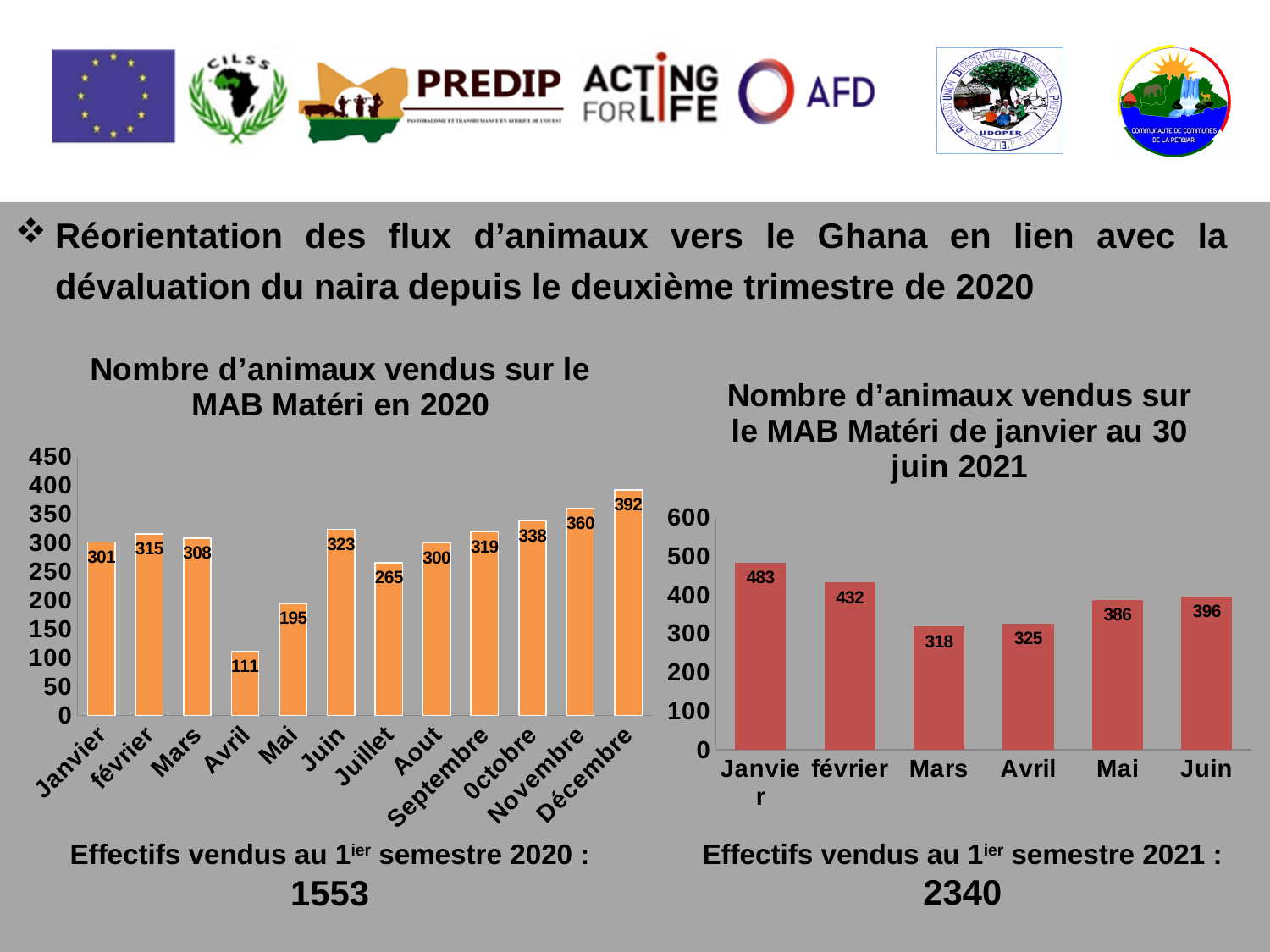
In the chart 'Nombre d'animaux vendus sur le MAB Matéri en 2020', what is the value for Avril? 111 In the chart 'Nombre d'animaux vendus sur le MAB Matéri en 2020', which month has the highest value? Décembre In the chart 'Nombre d'animaux vendus sur le MAB Matéri en 2020', is the value for Juillet larger or smaller than the value for Aout? smaller In the chart 'Nombre d'animaux vendus sur le MAB Matéri de janvier au 30 juin 2021', how many months are plotted? 6 In the chart 'Nombre d'animaux vendus sur le MAB Matéri en 2020', how many months are plotted? 12 In the chart 'Nombre d'animaux vendus sur le MAB Matéri de janvier au 30 juin 2021', which month has the highest value? Janvier In the chart 'Nombre d'animaux vendus sur le MAB Matéri de janvier au 30 juin 2021', is the value for Juin greater or less than 300? greater In the chart 'Nombre d'animaux vendus sur le MAB Matéri en 2020', which month has the lowest value? Avril In the chart 'Nombre d'animaux vendus sur le MAB Matéri en 2020', what is the difference between Décembre and Avril? 281 What kind of chart is 'Nombre d'animaux vendus sur le MAB Matéri de janvier au 30 juin 2021'? bar chart In the chart 'Nombre d'animaux vendus sur le MAB Matéri de janvier au 30 juin 2021', what is the value for Mars? 318 In the chart 'Nombre d'animaux vendus sur le MAB Matéri de janvier au 30 juin 2021', what is the difference between Janvier and février? 51